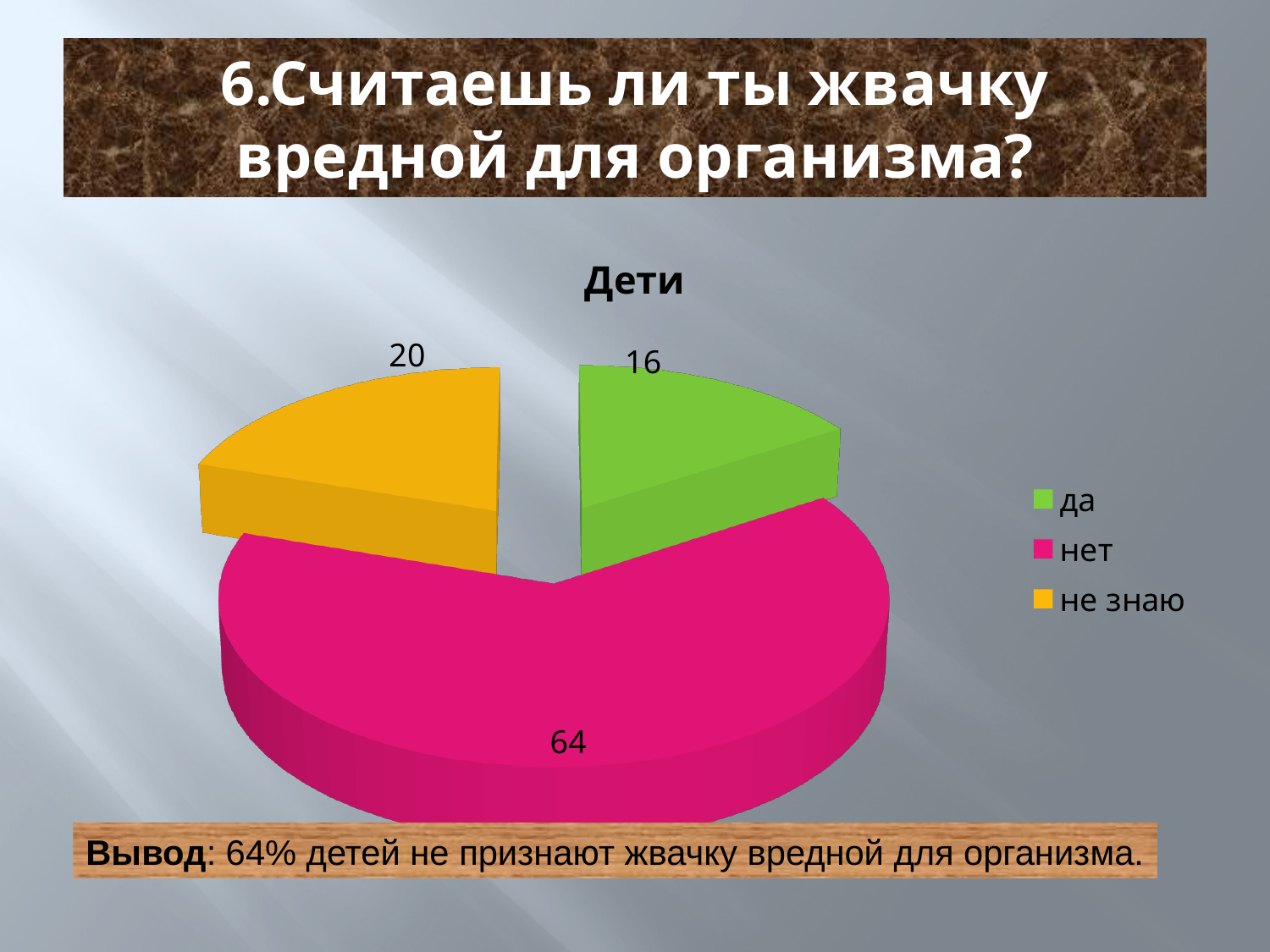
What is the difference between the 'нет' and 'да' values? 48 What is the title of the chart? Дети What colour is the 'нет' slice? pink Which category has the largest slice? нет What is the value for the 'не знаю' slice? 20 How many categories does the pie chart have? 3 What is the difference between the 'не знаю' and 'да' values? 4 What is the value for the 'нет' slice? 64 What type of chart is shown on the slide? pie chart What is the value for the 'да' slice? 16 Which is larger, the 'не знаю' slice or the 'да' slice? не знаю Which category has the smallest slice? да